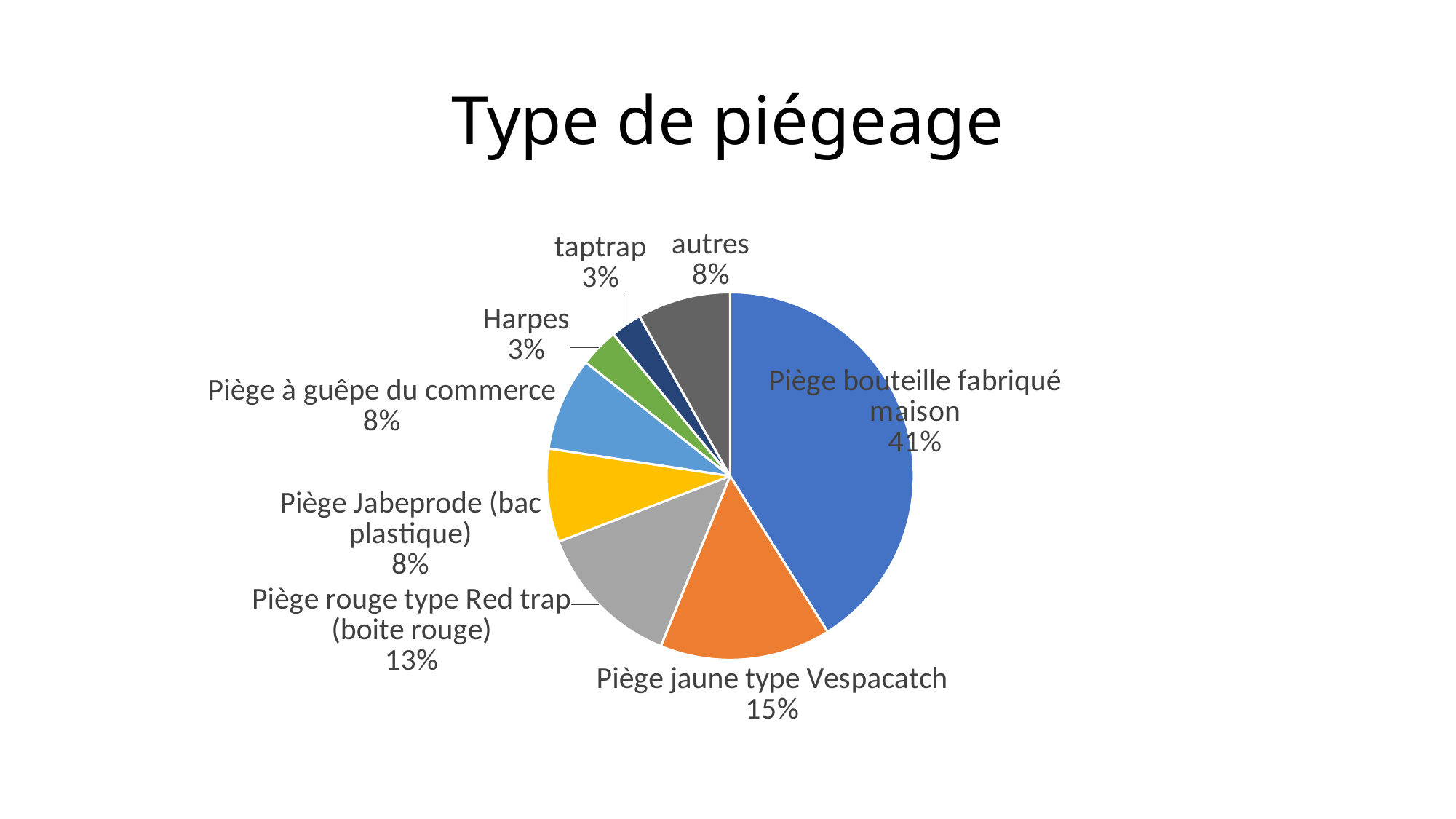
What is the value shown for "autres"? 8% What is the value shown for "Harpes"? 3% What is the difference between the shares of "Piège bouteille fabriqué maison" and "Piège jaune type Vespacatch"? 26% What share of the pie does "Piège bouteille fabriqué maison" represent? 41% What colour is the slice for "Piège jaune type Vespacatch"? orange What is the value shown for "Piège rouge type Red trap (boite rouge)"? 13% What kind of chart is shown on the slide? pie chart What is the value shown for "Piège jaune type Vespacatch"? 15% Which category has the largest slice of the pie? Piège bouteille fabriqué maison Which is larger, the share for "Piège rouge type Red trap (boite rouge)" or the share for "Piège Jabeprode (bac plastique)"? Piège rouge type Red trap (boite rouge) What is the title of the chart? Type de piégeage How many slices does the pie chart have? 8